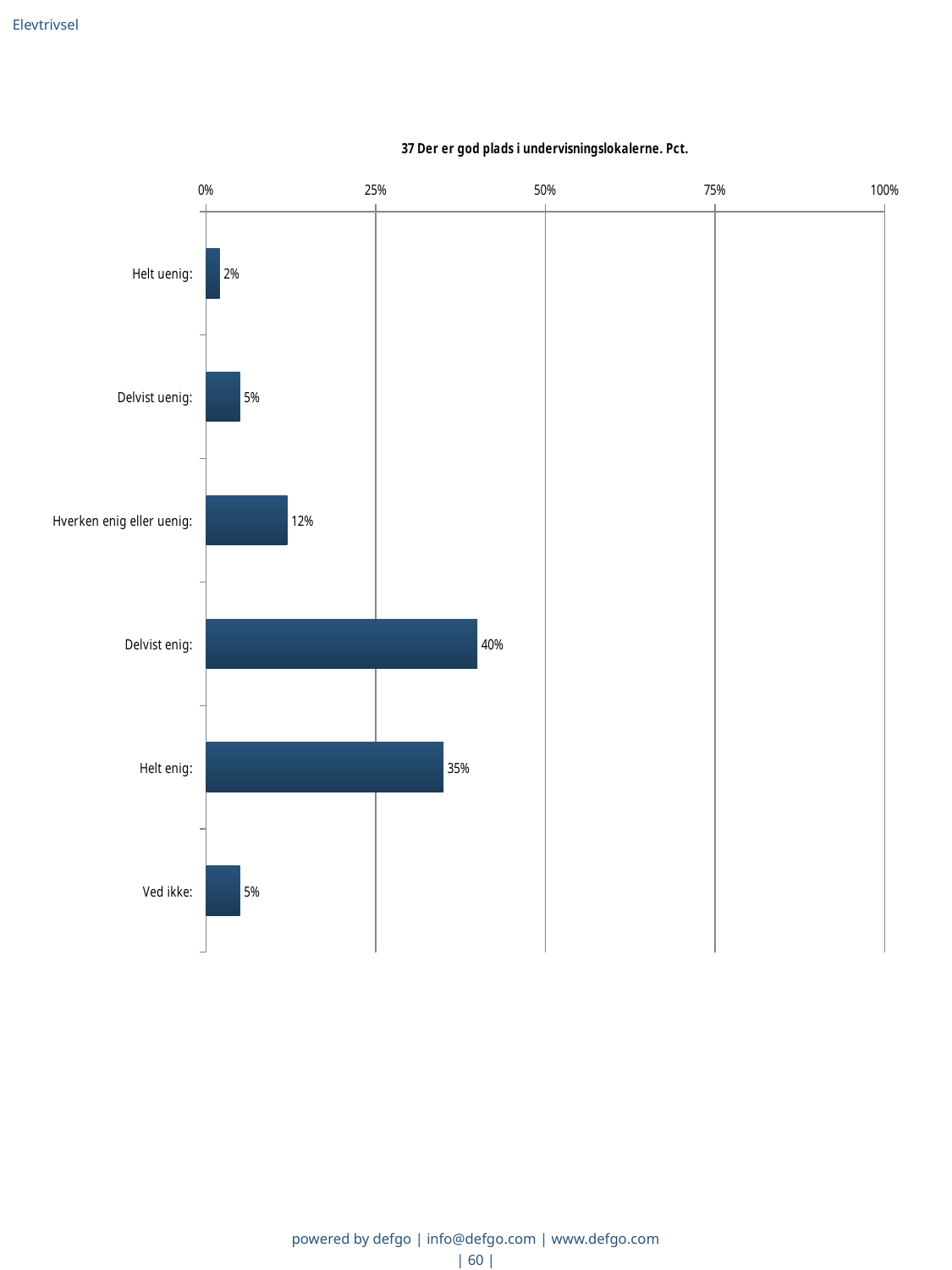
What is the value for Hverken enig eller uenig? 12% What is the value for Delvist enig? 40% Which category has the lowest value? Helt uenig What kind of chart is shown on the slide? Bar chart What is the difference between the values for Hverken enig eller uenig and Delvist uenig? 7% How many categories are shown in the chart? 6 Which category has the highest value? Delvist enig What is the value for Helt uenig? 2% What is the difference between the values for Delvist enig and Helt enig? 5% Is the value for Delvist enig greater or less than 25%? greater What is the title of the chart? 37 Der er god plads i undervisningslokalerne. Pct. Which is larger, the value for Helt enig or the value for Hverken enig eller uenig? Helt enig